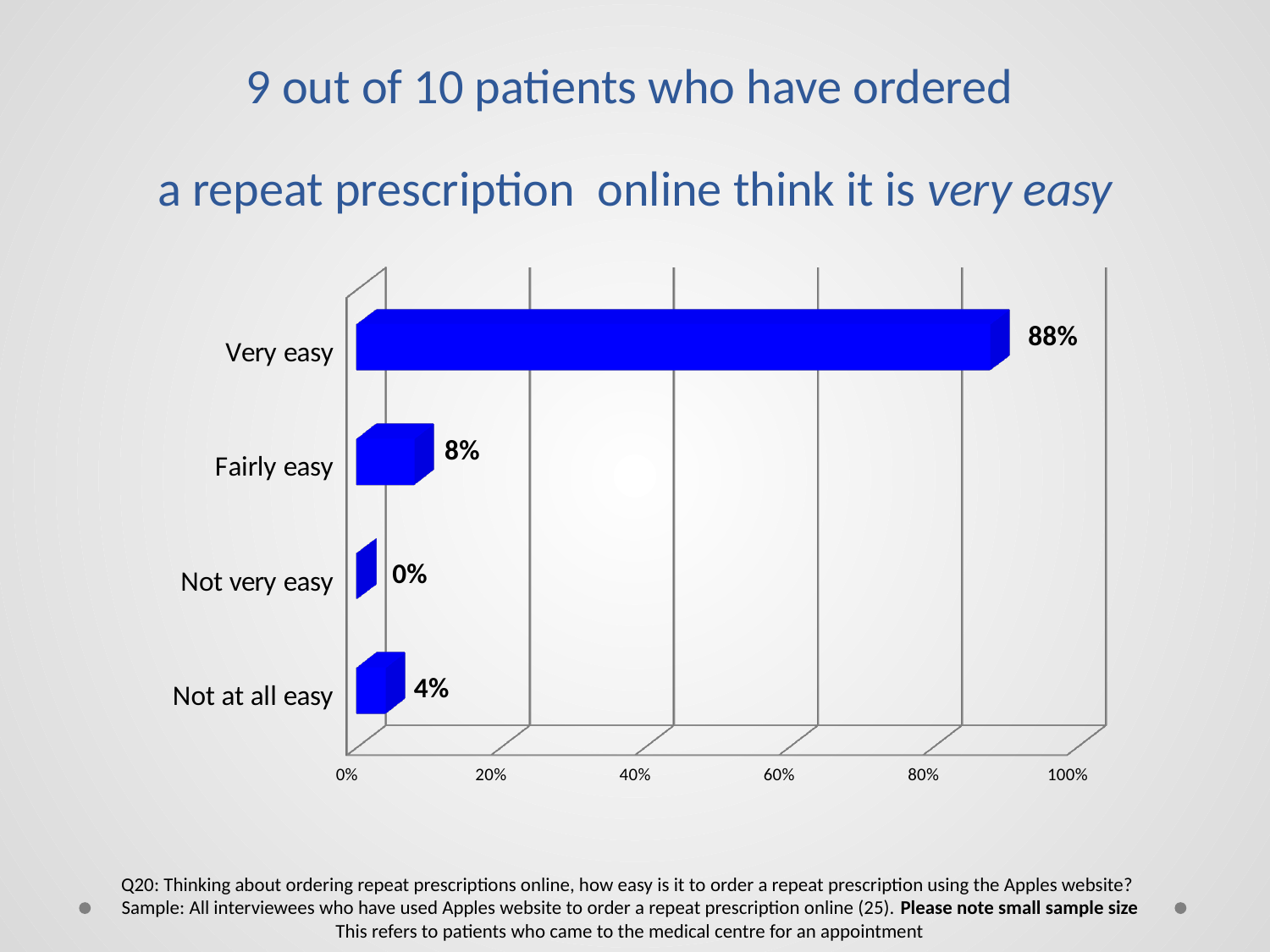
What is the maximum value shown on the x axis? 100% What percentage of patients said ordering a repeat prescription online was very easy? 88% What type of chart is shown on the slide? Bar chart What is the value shown for 'Not at all easy'? 4% Is the value for 'Very easy' greater or less than 80%? greater Which category has the lowest value? Not very easy What is the value shown for 'Fairly easy'? 8% What is the value shown for 'Not very easy'? 0% How many categories are shown in the chart? 4 What is the difference between the 'Very easy' and 'Fairly easy' values? 80 percentage points Which is larger, the value for 'Fairly easy' or 'Not at all easy'? Fairly easy Which category has the highest value? Very easy